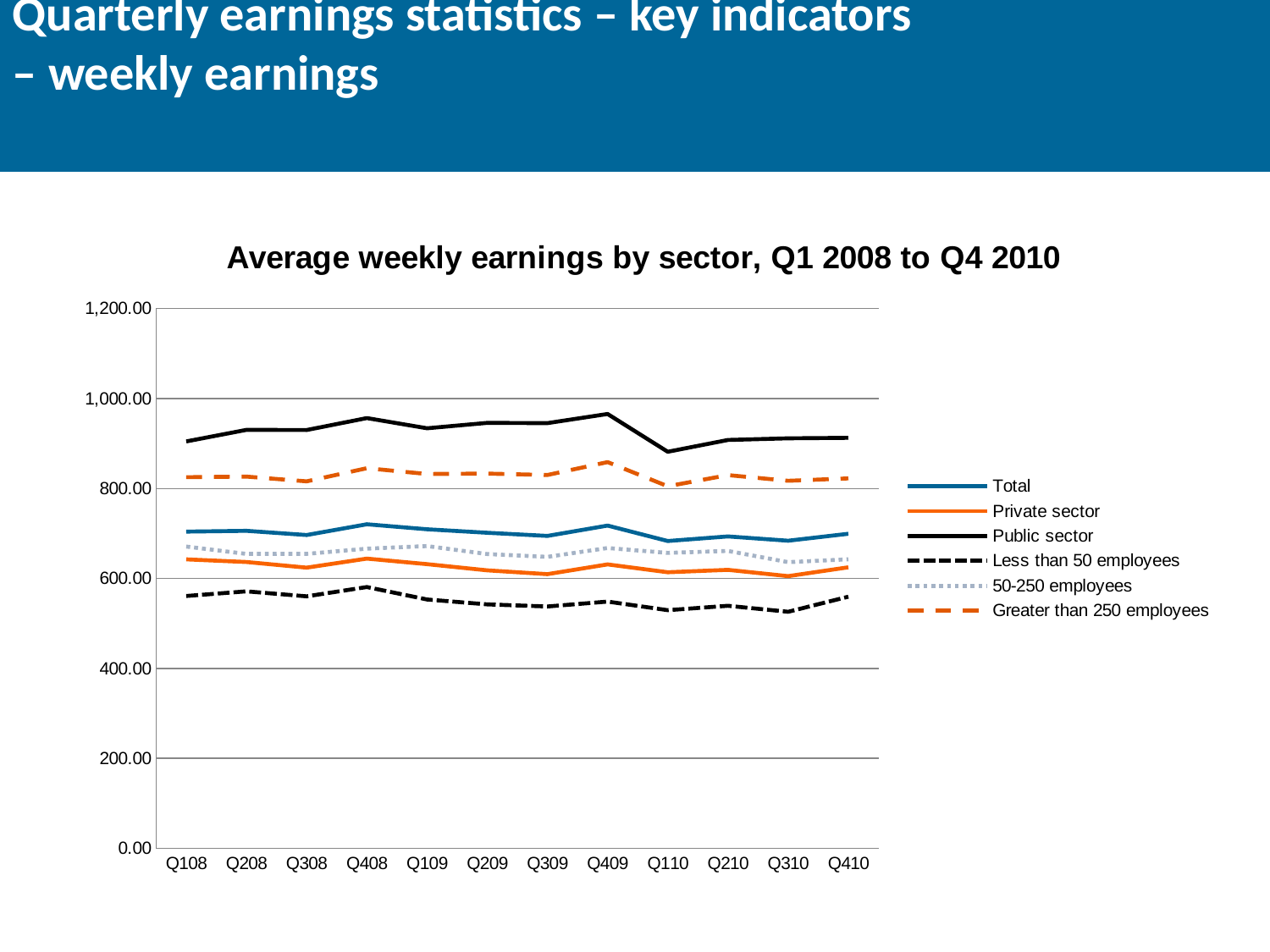
Which series has the highest values across all quarters? Public sector Does the Public sector line rise or fall from Q409 to Q110? Fall Which series has the lowest values across all quarters? Less than 50 employees Is the Total value for Q408 greater or less than 600.00? greater Is the value for Less than 50 employees in Q310 greater or less than 600.00? less In Q410, which is larger: Greater than 250 employees or 50-250 employees? Greater than 250 employees How many series does the legend list? 6 How many quarters are plotted along the x axis? 12 Is the Public sector value for Q409 greater or less than 1,000.00? less What is the title of the chart? Average weekly earnings by sector, Q1 2008 to Q4 2010 In Q108, which is larger: Public sector or Private sector? Public sector What type of chart is shown on the slide? Line chart